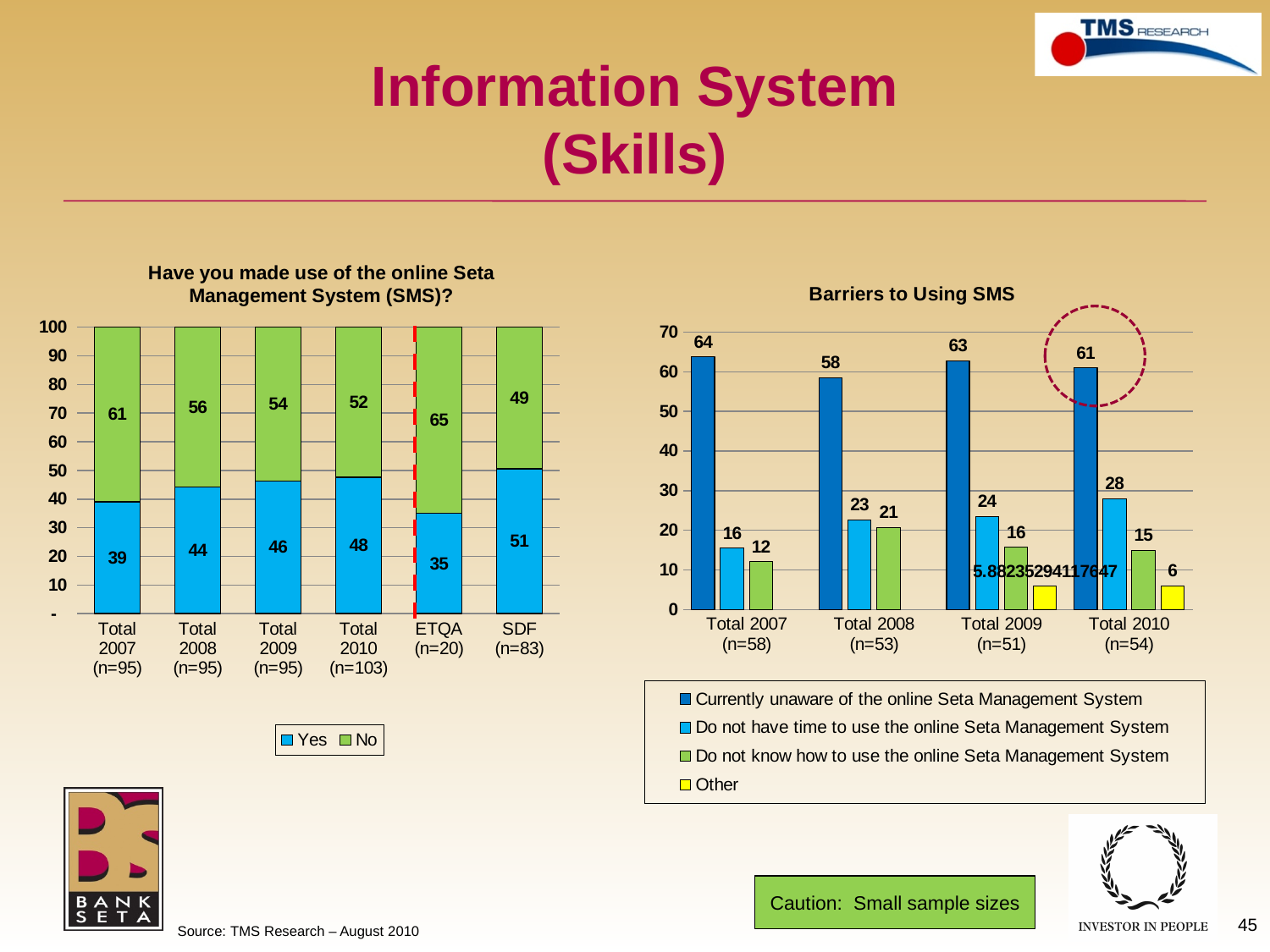
On the 'Have you made use of the online Seta Management System (SMS)?' chart, what is the No value for ETQA (n=20)? 65 On the 'Have you made use of the online Seta Management System (SMS)?' chart, what is the Yes value for Total 2010 (n=103)? 48 What type of chart is the 'Barriers to Using SMS' chart? bar chart On the 'Have you made use of the online Seta Management System (SMS)?' chart, what is the difference between the No and Yes values for Total 2007 (n=95)? 22 On the 'Have you made use of the online Seta Management System (SMS)?' chart, which category has the lowest Yes value? ETQA (n=20) On the 'Barriers to Using SMS' chart, how many series does the legend list? 4 On the 'Have you made use of the online Seta Management System (SMS)?' chart, how many series does the legend list? 2 On the 'Barriers to Using SMS' chart, what is the value for 'Currently unaware of the online Seta Management System' in Total 2008 (n=53)? 58 On the 'Have you made use of the online Seta Management System (SMS)?' chart, which category has the highest Yes value? SDF (n=83) On the 'Have you made use of the online Seta Management System (SMS)?' chart, do the Yes values rise or fall from Total 2007 to Total 2010? rise On the 'Barriers to Using SMS' chart, what is the value for 'Do not have time to use the online Seta Management System' in Total 2010 (n=54)? 28 On the 'Barriers to Using SMS' chart, which is larger for Total 2007 (n=58): 'Do not have time to use the online Seta Management System' or 'Do not know how to use the online Seta Management System'? Do not have time to use the online Seta Management System